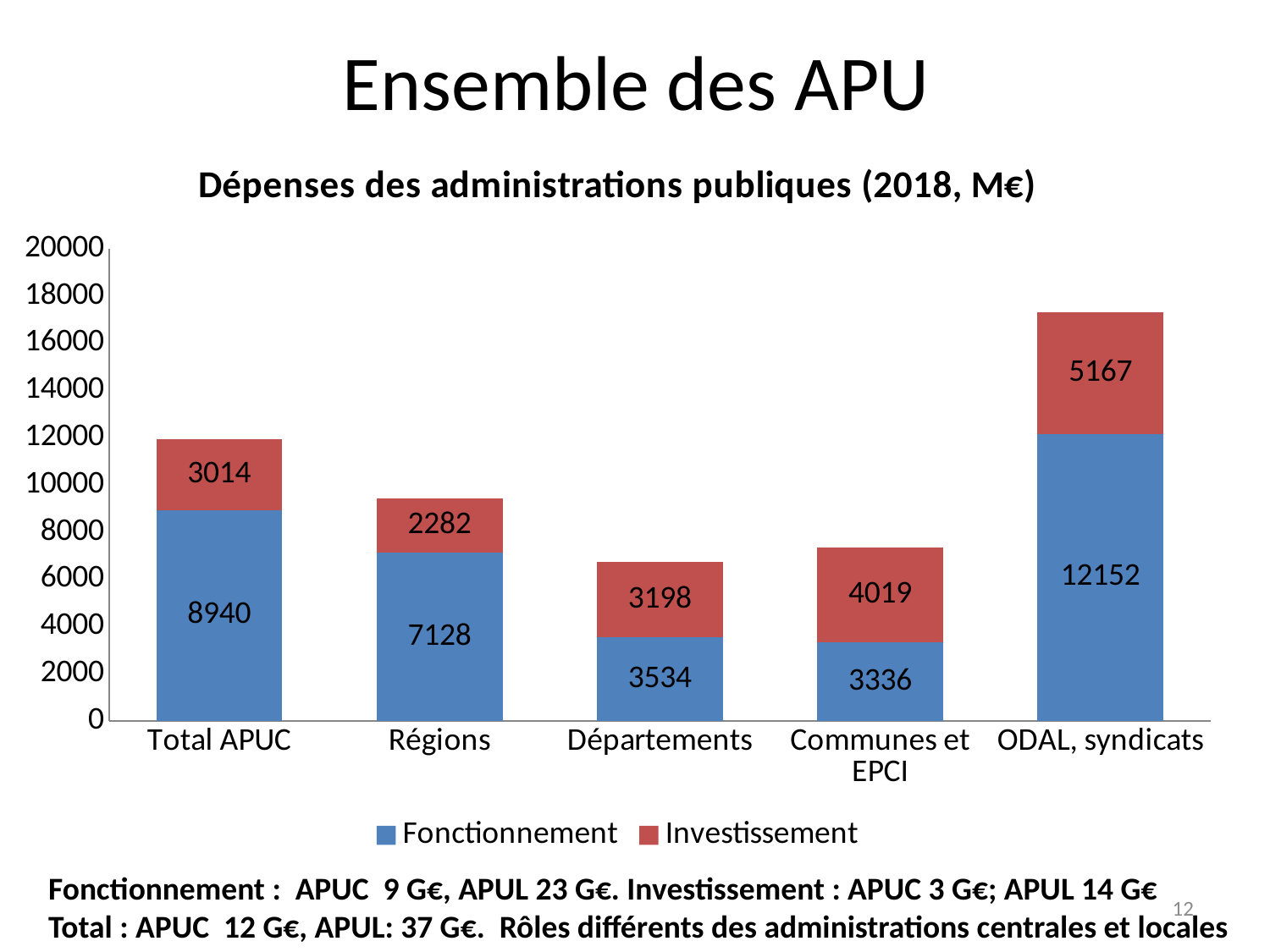
How many series does the legend list? 2 What kind of chart is shown on the slide? Stacked bar chart Which is larger for Départements: Fonctionnement or Investissement? Fonctionnement What is the Fonctionnement value for ODAL, syndicats? 12152 What is the Investissement value for Communes et EPCI? 4019 How many categories are shown on the x axis? 5 Which category has the highest Fonctionnement value? ODAL, syndicats What is the total of the stacked bar for Total APUC? 11954 What is the total of the stacked bar for ODAL, syndicats? 17319 Which category has the lowest Investissement value? Régions What is the difference between the Fonctionnement values for Total APUC and Régions? 1812 What is the Fonctionnement value for Régions? 7128